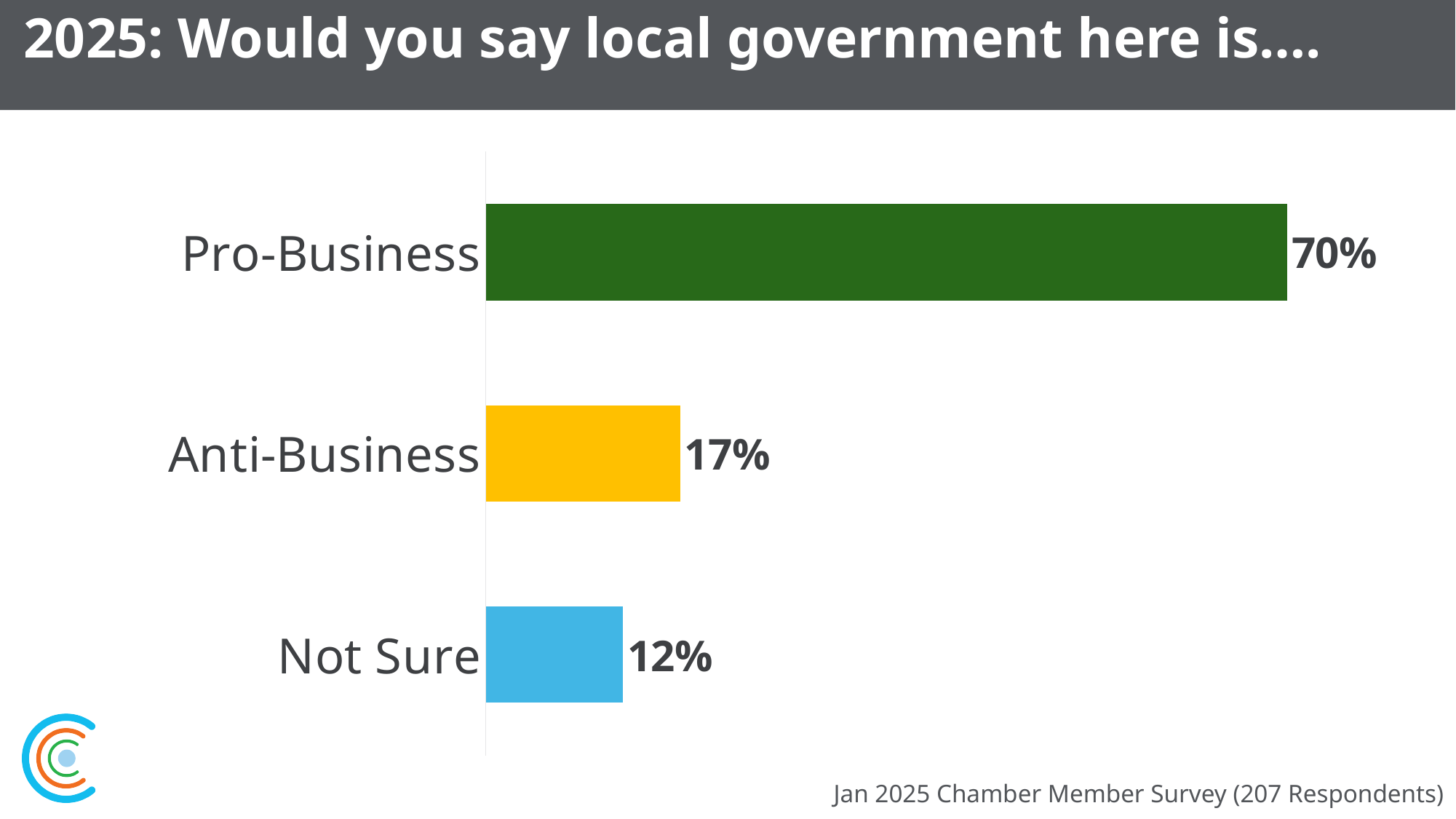
What is the difference in percentage points between Pro-Business and Anti-Business? 53 What percentage of respondents answered Not Sure? 12% What kind of chart is shown on the slide? Bar chart Which is larger, the value for Anti-Business or the value for Not Sure? Anti-Business How many categories are shown in the chart? 3 What percentage of respondents said local government is Pro-Business? 70% How many respondents took part in the survey, according to the source note? 207 Which category has the highest percentage? Pro-Business What is the difference in percentage points between Anti-Business and Not Sure? 5 What percentage of respondents said local government is Anti-Business? 17% What colour is the Pro-Business bar? Green Which category has the lowest percentage? Not Sure